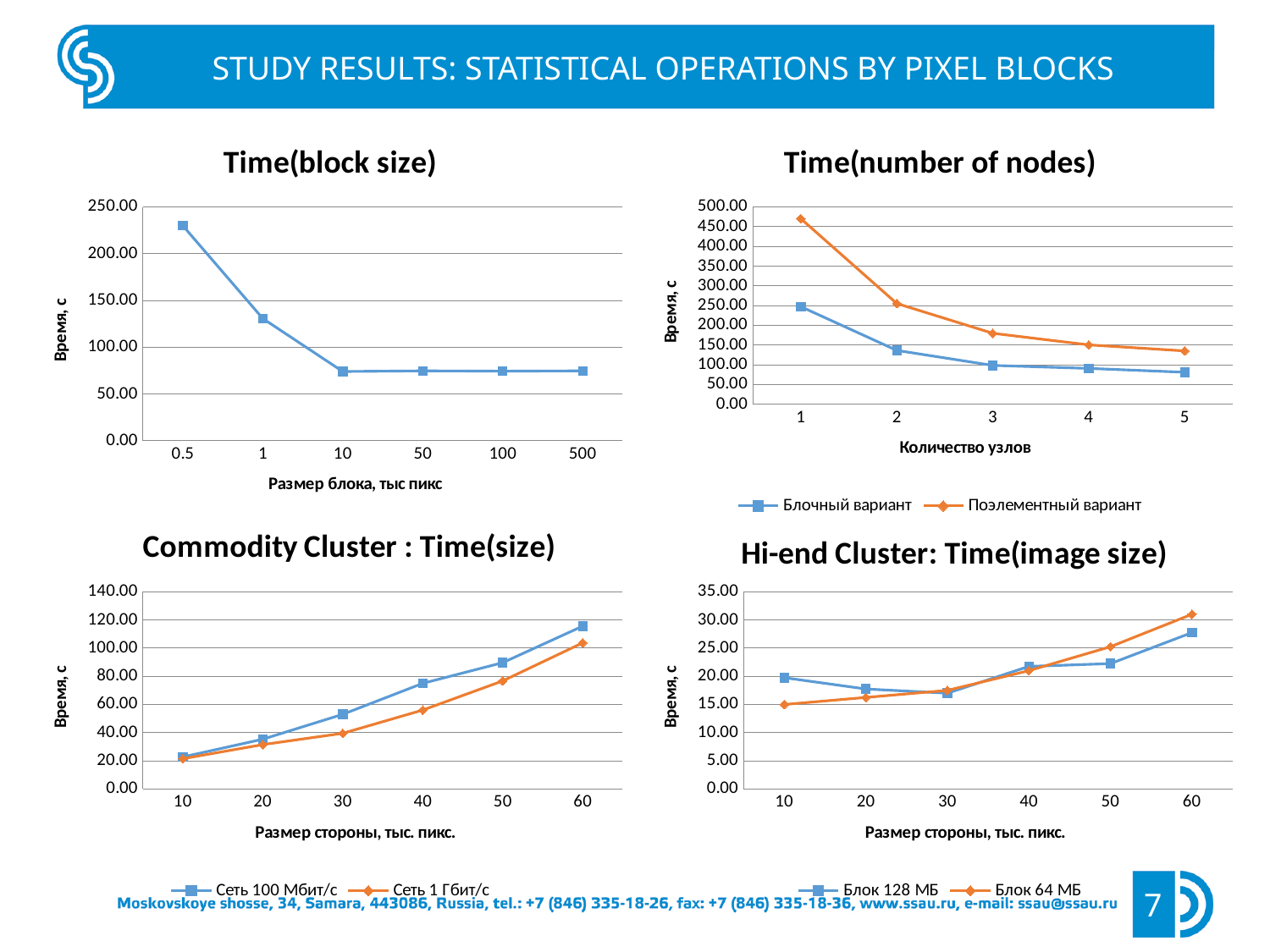
In the "Commodity Cluster : Time(size)" chart, do the values rise or fall as the side size increases? rise In the "Hi-end Cluster: Time(image size)" chart, what are the two series listed in the legend? Блок 128 МБ and Блок 64 МБ In the "Commodity Cluster : Time(size)" chart, which series has the larger value at side size 40: Сеть 100 Мбит/с or Сеть 1 Гбит/с? Сеть 100 Мбит/с In the "Time(block size)" chart, is the value for block size 10 greater or less than 100.00? less In the "Time(number of nodes)" chart, is the value of Поэлементный вариант at 1 node greater or less than 400.00? greater What kind of chart is the "Time(block size)" chart? line chart In the "Hi-end Cluster: Time(image size)" chart, is the value of Блок 128 МБ at side size 60 greater or less than 30.00? less In the "Time(number of nodes)" chart, how many series does the legend list? 2 In the "Time(number of nodes)" chart, do the values rise or fall as the number of nodes increases? fall In the "Time(block size)" chart, which block size has the highest time? 0.5 In the "Time(block size)" chart, how many block sizes are plotted on the x axis? 6